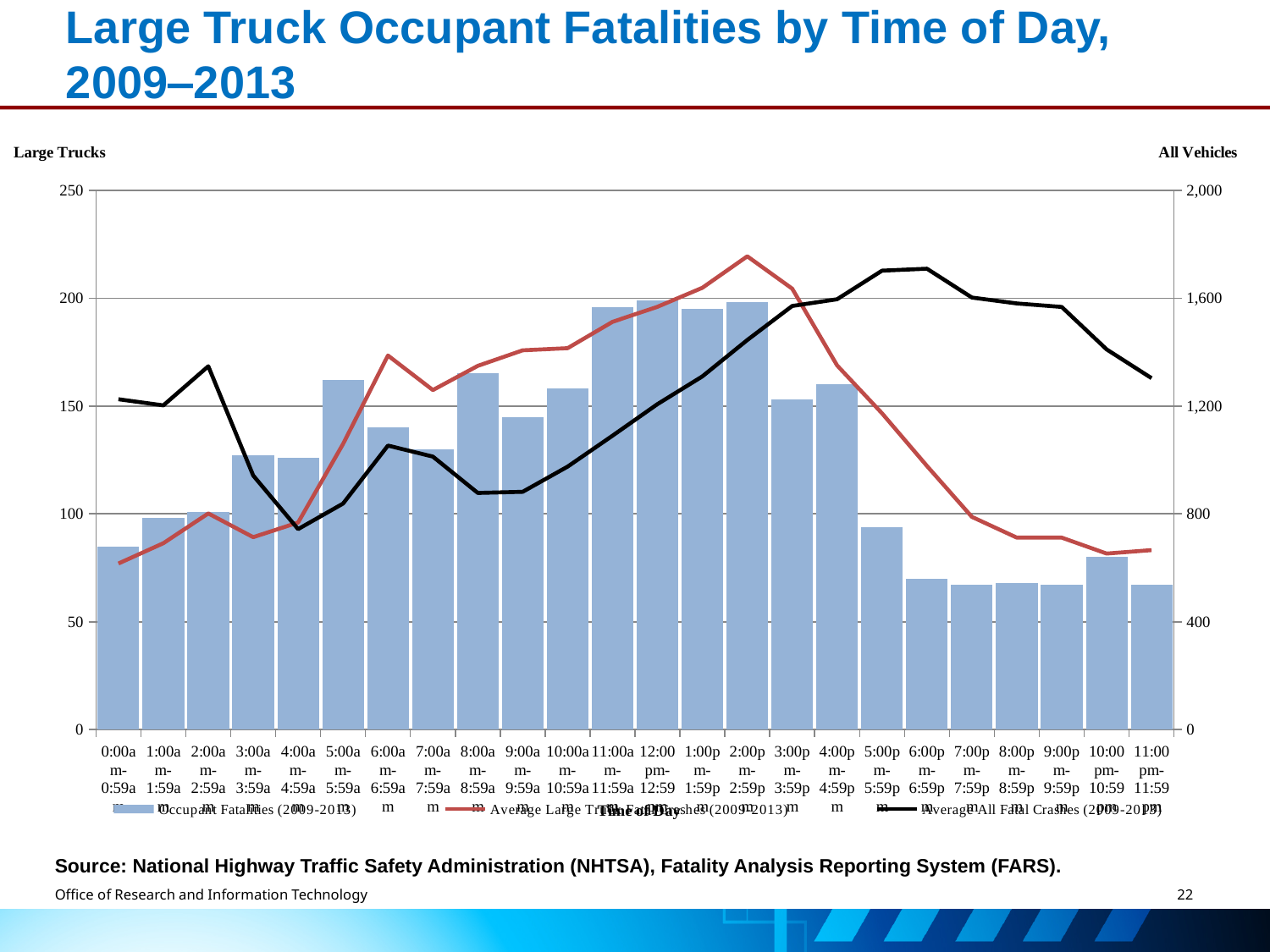
How many series does the chart's legend list? 3 Is the Occupant Fatalities bar for 5:00pm-5:59pm greater or less than 100? less Does the Average All Fatal Crashes line rise or fall from 6:00pm-6:59pm to 11:00pm-11:59pm? fall Which time of day has the highest value on the Average Large Truck Fatal Crashes line? 2:00pm-2:59pm Which time of day has the lowest value on the Average Large Truck Fatal Crashes line? 0:00am-0:59am How many time-of-day categories are shown on the x axis of the chart? 24 Which time of day has the lowest value on the Average All Fatal Crashes line? 4:00am-4:59am Is the Occupant Fatalities bar for 0:00am-0:59am greater or less than 100? less Is the Occupant Fatalities bar for 5:00am-5:59am greater or less than 150? greater What is the title of the right-hand vertical axis? All Vehicles Which has the larger Occupant Fatalities bar, 4:00am-4:59am or 5:00am-5:59am? 5:00am-5:59am What kind of chart is shown on the slide? Combined bar and line chart